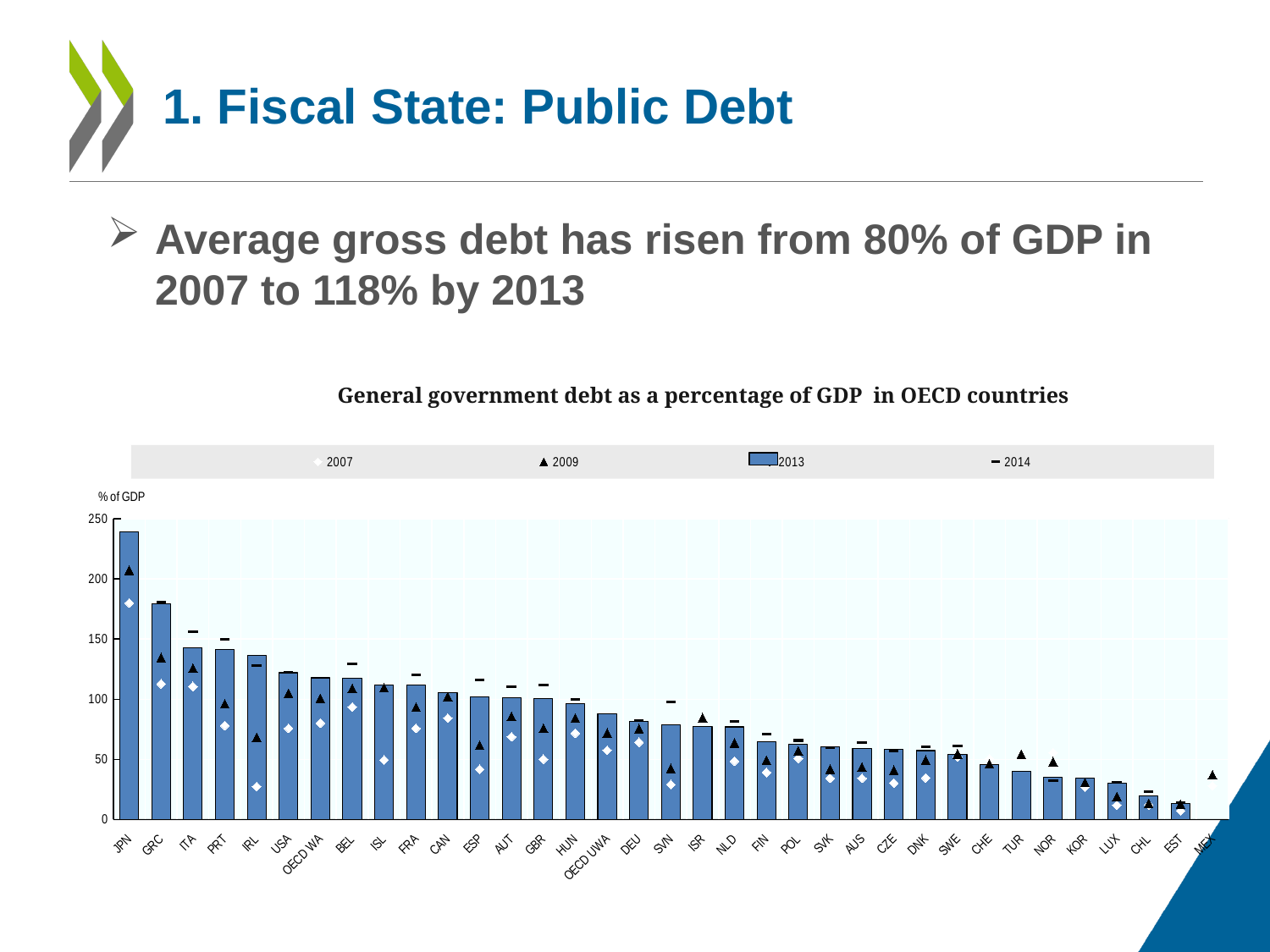
How many series does the chart legend list? 4 What kind of chart is shown on the slide? bar chart Is the 2013 value for JPN greater or less than 200? greater How many countries or groups are shown along the x axis of the chart? 35 Which country has the highest 2013 bar in the chart? JPN Is the 2013 value for EST greater or less than 50? less Which has the larger 2013 bar, USA or CHE? USA Is the 2013 value for DEU greater or less than 100? less Which years are listed in the chart legend? 2007, 2009, 2013, 2014 What is the title of the chart? General government debt as a percentage of GDP in OECD countries Do the 2013 bars generally rise or fall moving from left to right along the x axis? fall